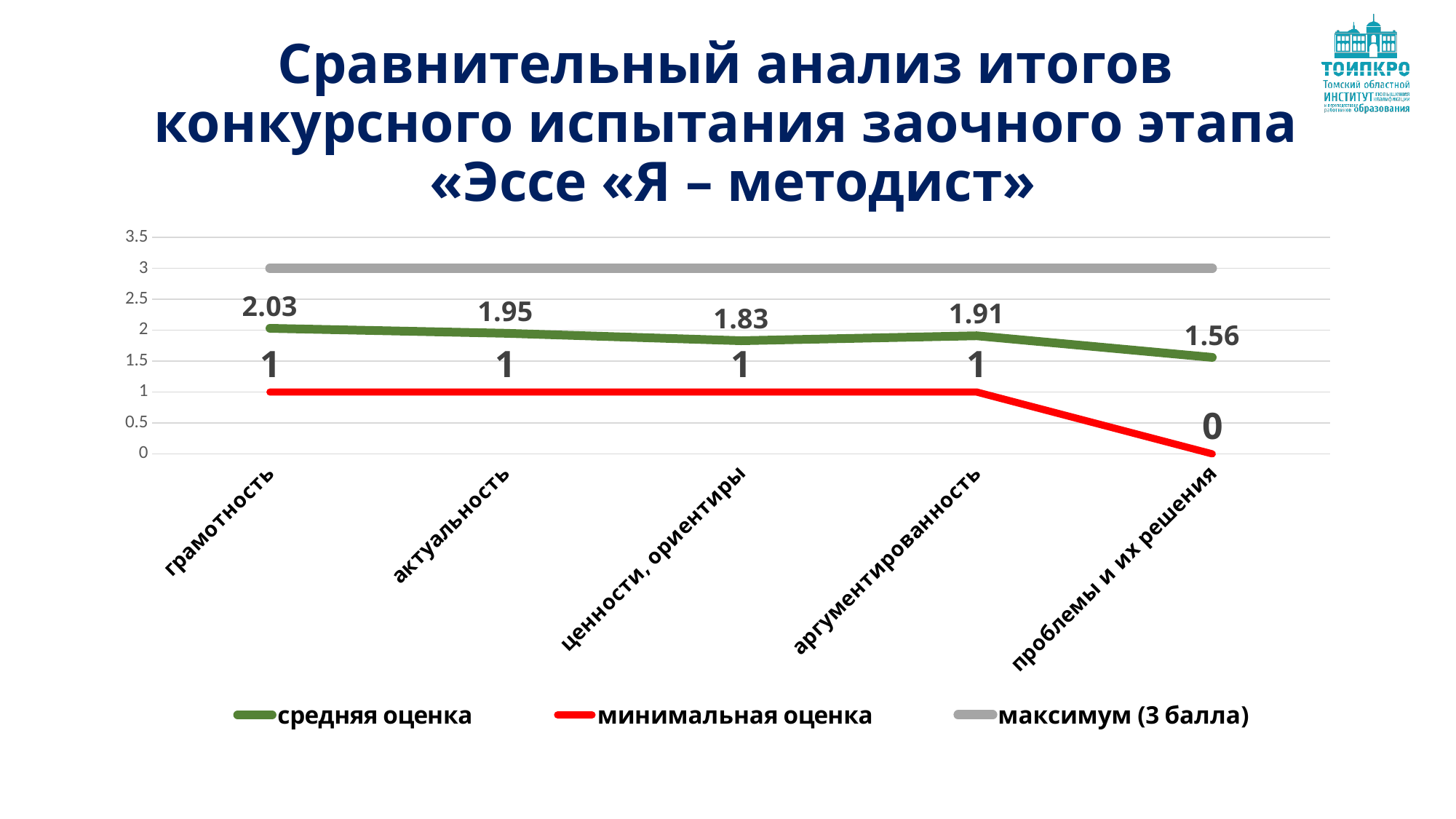
What colour is the минимальная оценка line? red Which is larger, the средняя оценка for актуальность or for аргументированность? актуальность Which category has the lowest средняя оценка? проблемы и их решения What is the difference between the средняя оценка for грамотность and for ценности, ориентиры? 0.2 How many series does the legend list? 3 What is the средняя оценка for грамотность? 2.03 What kind of chart is shown on the slide? line chart What is the минимальная оценка for аргументированность? 1 What is the средняя оценка for проблемы и их решения? 1.56 Is the максимум (3 балла) line greater or less than 2.5? greater Which category has the highest средняя оценка? грамотность How many categories are shown on the x axis? 5